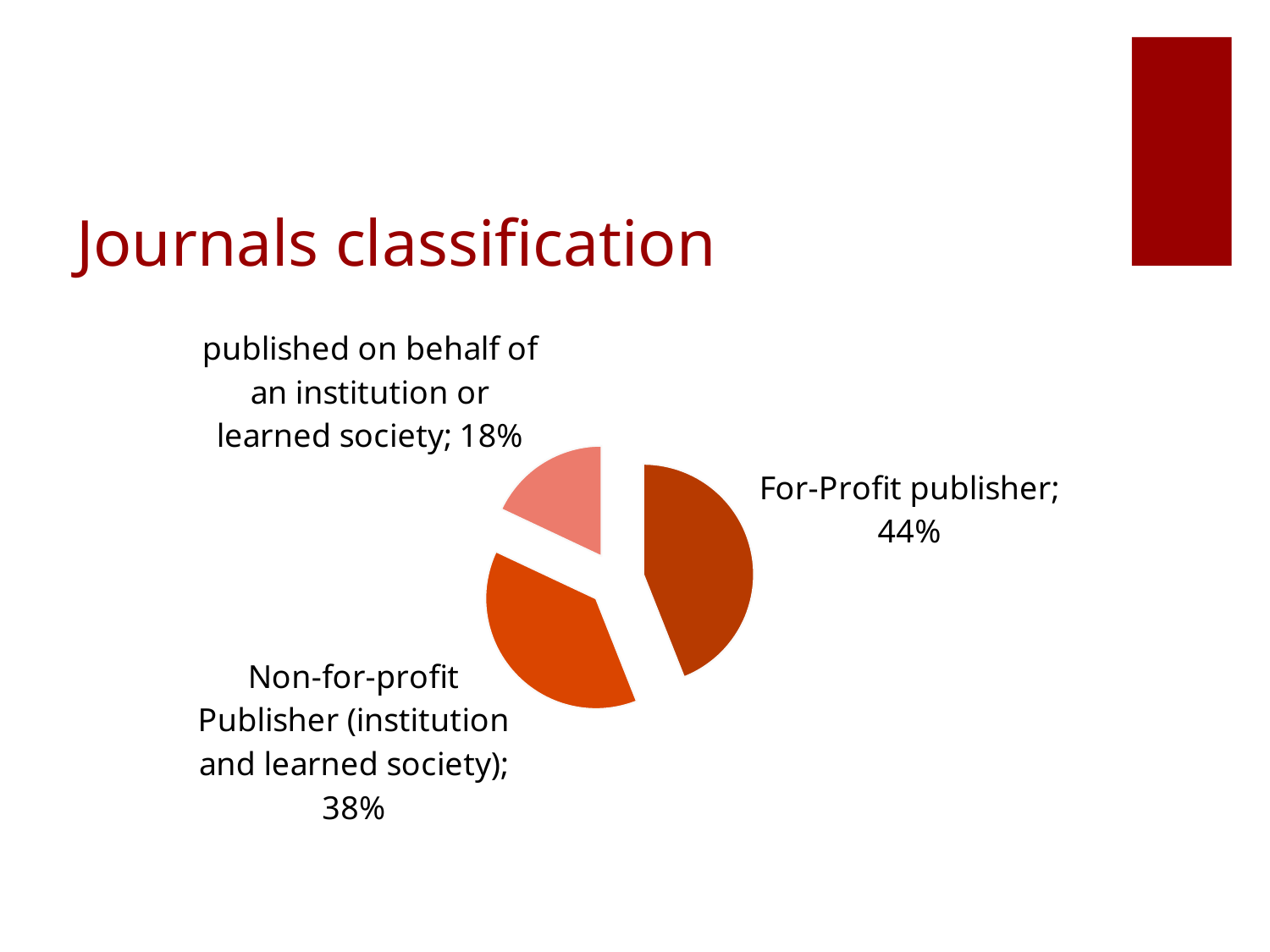
What is the title of the slide containing the chart? Journals classification Which category has the smallest share of the pie? published on behalf of an institution or learned society What is the difference in percentage points between the For-Profit publisher share and the Non-for-profit Publisher share? 6 How many categories does the pie chart show? 3 What kind of chart is shown on the slide? pie chart Which is larger: the For-Profit publisher share or the Non-for-profit Publisher share? For-Profit publisher What is the difference in percentage points between the Non-for-profit Publisher share and the share published on behalf of an institution or learned society? 20 What share of journals is published by a For-Profit publisher? 44% Which category is shown in the lightest (pink) colour? published on behalf of an institution or learned society What share of journals is published on behalf of an institution or learned society? 18% What share of journals is published by a Non-for-profit Publisher (institution and learned society)? 38% Which category has the largest share of the pie? For-Profit publisher